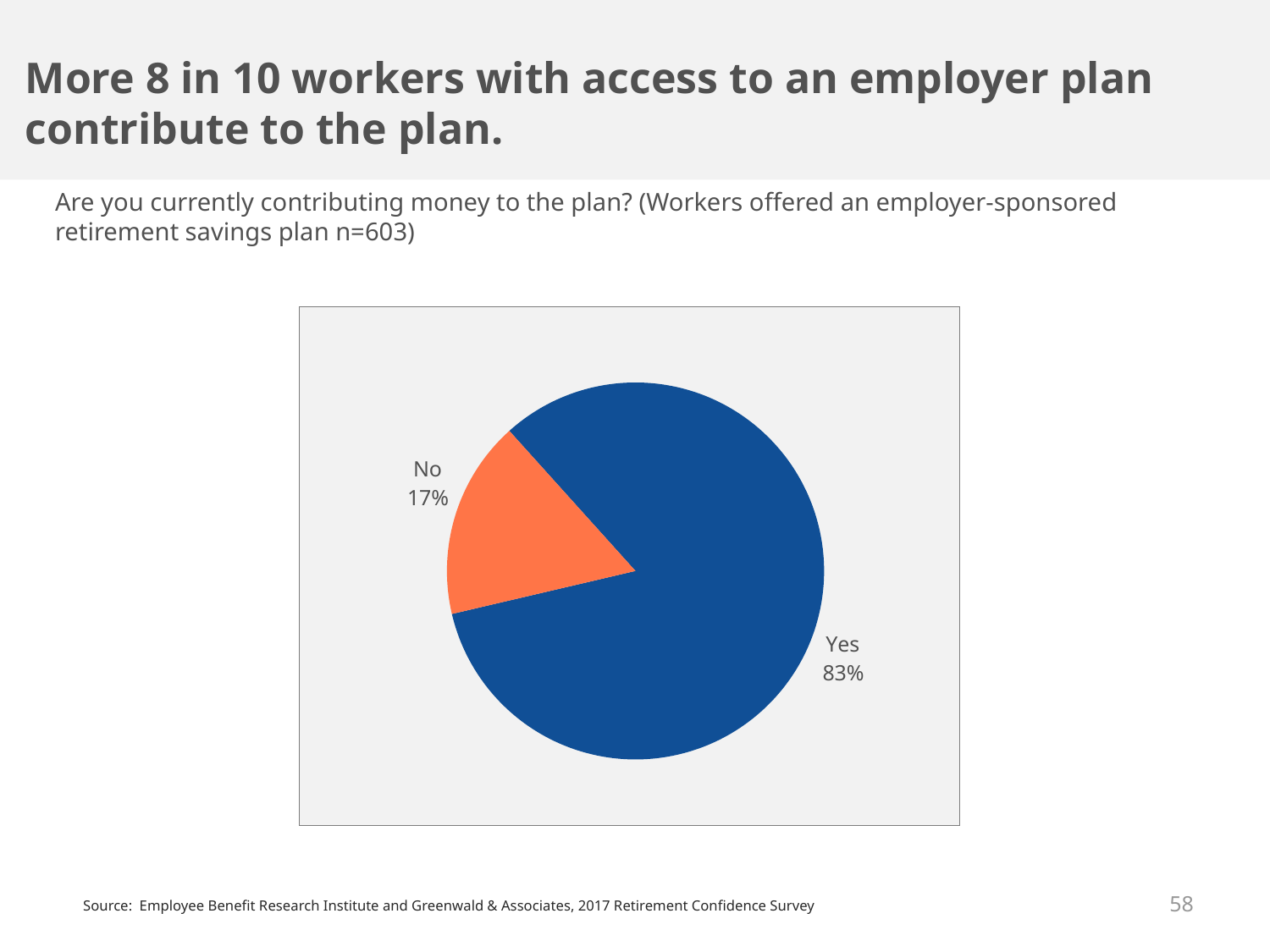
What is the difference in percentage points between the Yes and No slices? 66 Which slice is larger, Yes or No? Yes What percentage of workers answered No to currently contributing money to the plan? 17% What colour is the Yes slice of the pie? Blue Which response has the smallest share of the pie? No What is the sample size (n) of workers offered an employer-sponsored retirement savings plan shown on the slide? 603 What percentage of workers answered Yes to currently contributing money to the plan? 83% What kind of chart is shown on the slide? Pie chart Which response has the largest share of the pie? Yes What share of the pie does the No slice represent? 17% How many slices does the pie chart have? 2